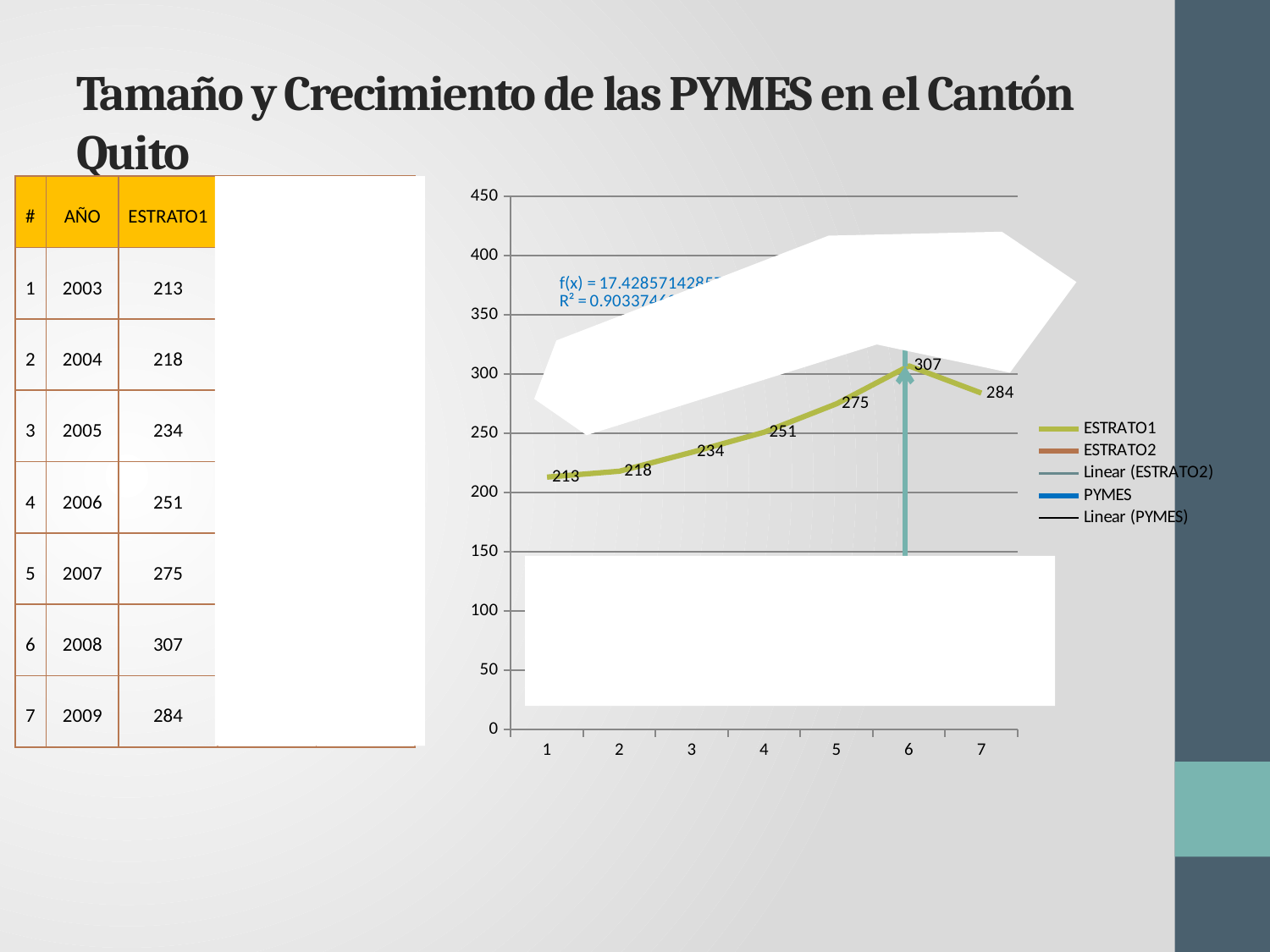
Which is larger for ESTRATO1: the value at x = 7 or the value at x = 5? x = 7 How many entries does the chart legend list? 5 Is the ESTRATO1 value at x = 3 greater or less than 250? less What is the ESTRATO1 value at x = 4 on the chart? 251 At which x-axis point does the ESTRATO1 series have its lowest value? 1 What is the difference between the ESTRATO1 values at x = 6 and x = 7? 23 What kind of chart is shown on the slide? line chart What is the difference between the ESTRATO1 values at x = 5 and x = 1? 62 At which x-axis point does the ESTRATO1 series reach its highest value? 6 What is the ESTRATO1 value at x = 6 on the chart? 307 What is the ESTRATO1 value at x = 1 on the chart? 213 How many data points are labelled on the ESTRATO1 line? 7